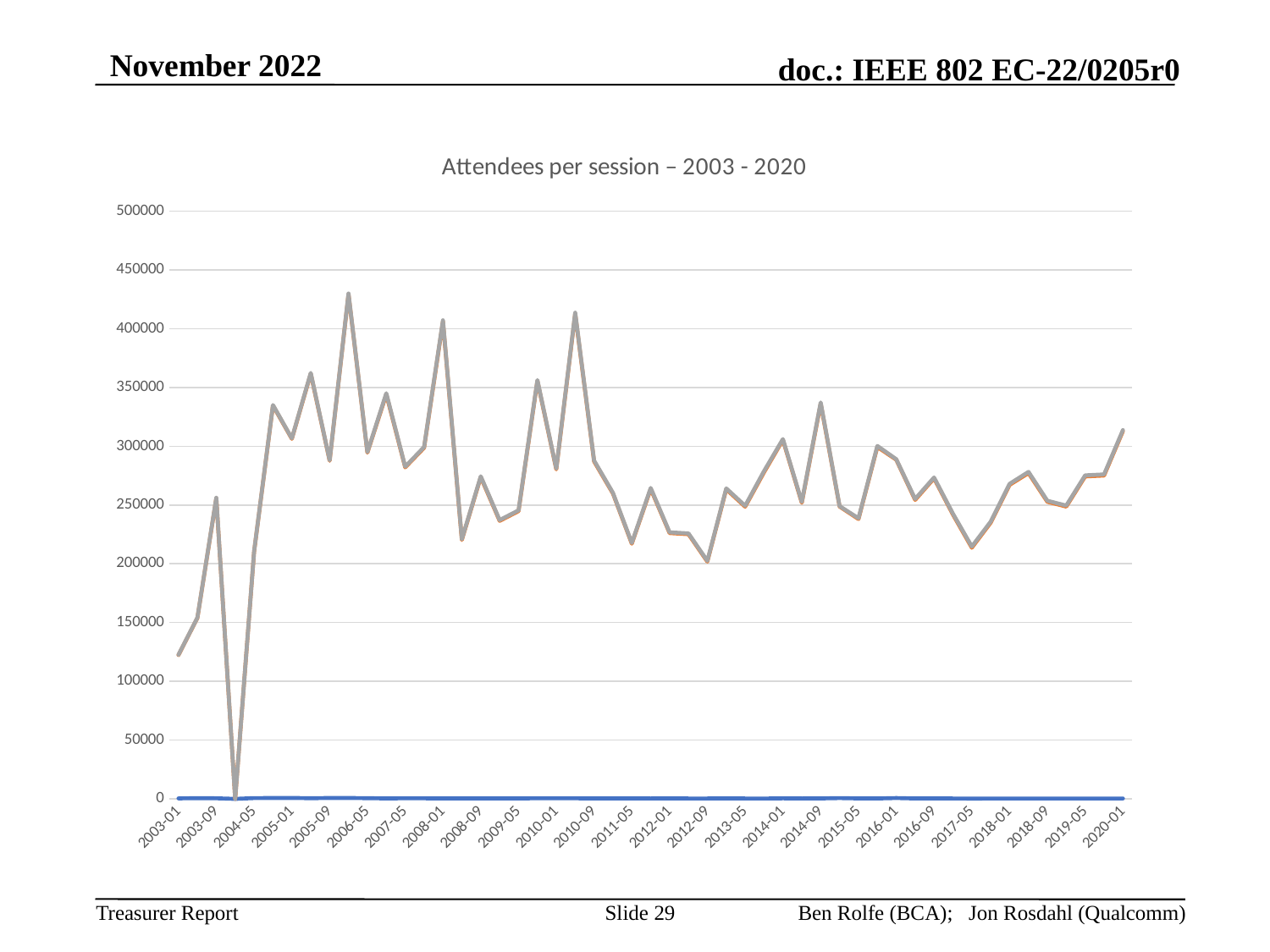
Is the value for 2020-01 greater or less than 250000? greater What is the first x-axis label on the chart? 2003-01 What kind of chart is shown on the slide? line chart Does the line ever exceed 450000? no Does the line rise or fall between 2003-01 and 2003-09? rise Is the value for 2003-01 greater or less than 150000? less Which is larger, the value for 2003-01 or the value for 2020-01? 2020-01 What is the title of the chart? Attendees per session – 2003 - 2020 What is the highest value shown on the y axis? 500000